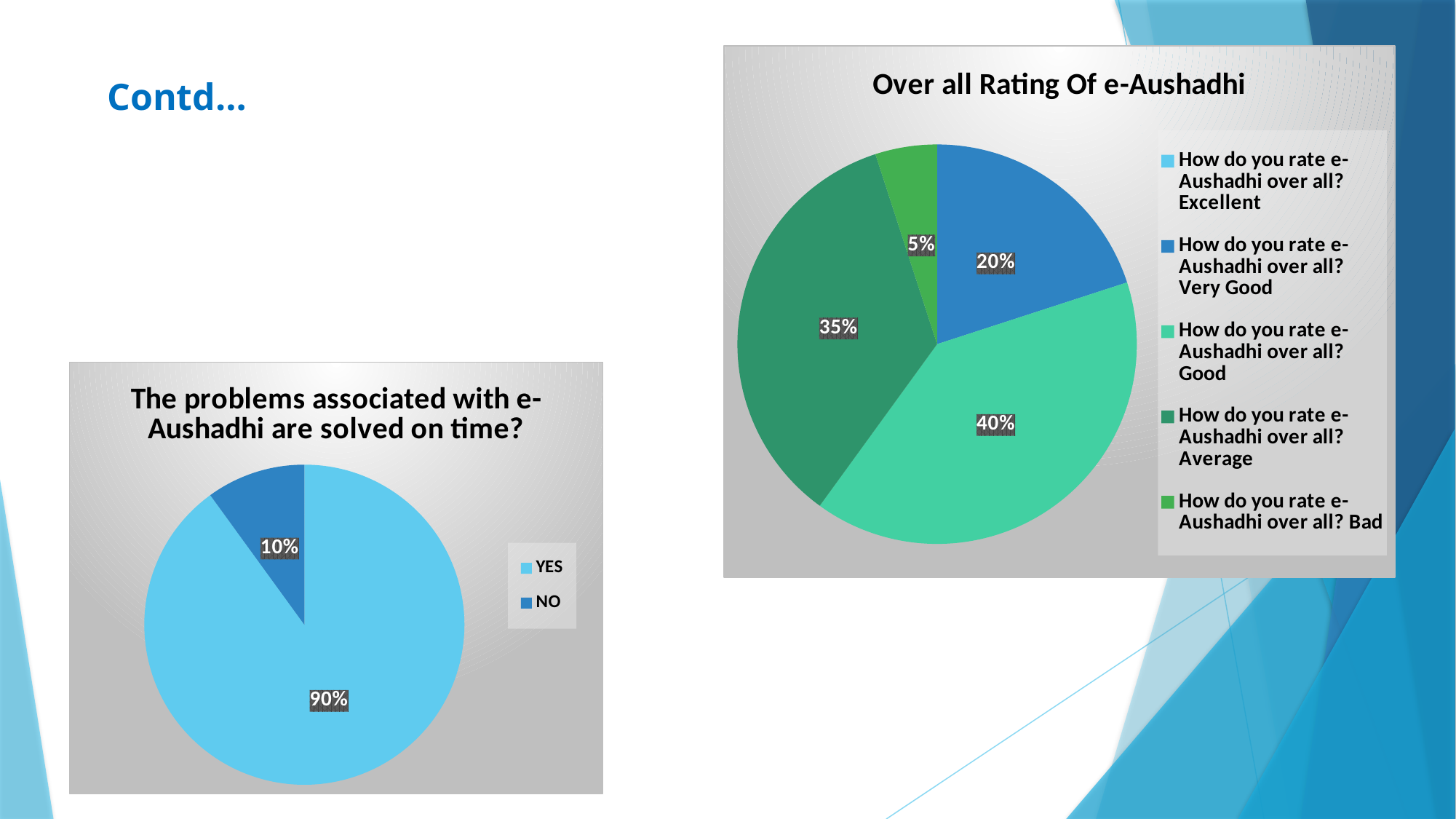
In the chart titled "Over all Rating Of e-Aushadhi", which rating has the smallest labelled slice? Bad In the chart titled "Over all Rating Of e-Aushadhi", what percentage is shown for the Good rating? 40% In the chart titled "The problems associated with e-Aushadhi are solved on time?", what is the difference in percentage points between YES and NO? 80 In the chart titled "The problems associated with e-Aushadhi are solved on time?", what percentage is shown for YES? 90% In the chart titled "The problems associated with e-Aushadhi are solved on time?", which category has the largest slice? YES In the chart titled "Over all Rating Of e-Aushadhi", which is larger, the Very Good slice or the Average slice? Average In the chart titled "Over all Rating Of e-Aushadhi", what percentage is shown for the Average rating? 35% How many entries does the legend of the chart titled "Over all Rating Of e-Aushadhi" list? 5 What kind of chart is the one titled "The problems associated with e-Aushadhi are solved on time?"? pie chart In the chart titled "Over all Rating Of e-Aushadhi", what percentage is shown for the Very Good rating? 20% In the chart titled "The problems associated with e-Aushadhi are solved on time?", what percentage is shown for NO? 10% In the chart titled "Over all Rating Of e-Aushadhi", what is the difference in percentage points between the Good and Bad ratings? 35